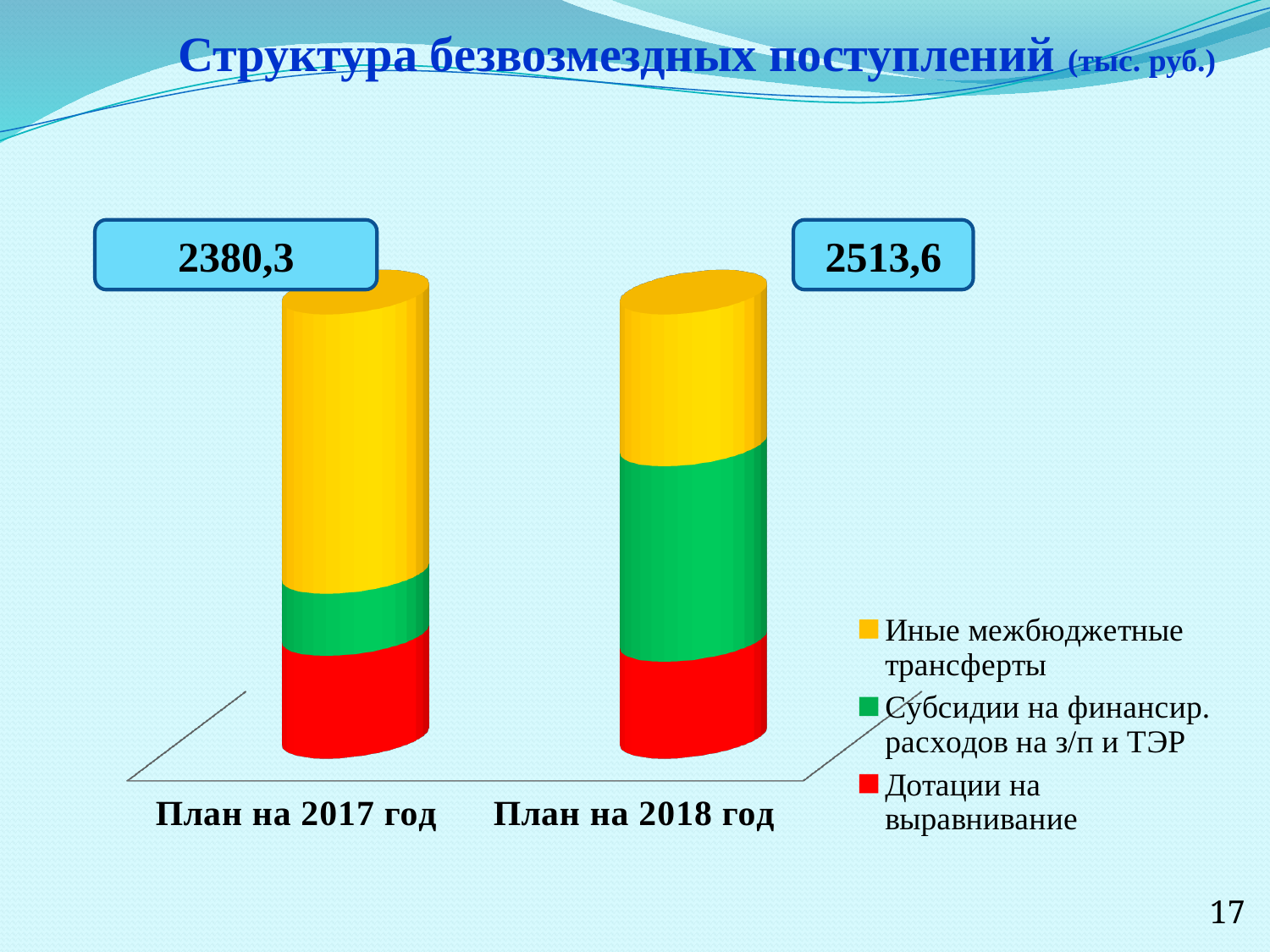
Which series makes up the smallest part of the "План на 2017 год" bar? Субсидии на финансир. расходов на з/п и ТЭР What is the total value shown for "План на 2018 год"? 2513,6 What kind of chart is shown on the slide? stacked bar chart Which colour represents "Дотации на выравнивание" in the legend? red Which series makes up the largest part of the "План на 2017 год" bar? Иные межбюджетные трансферты What is the total value shown for "План на 2017 год"? 2380,3 How many categories (bars) are shown on the chart? 2 Which bar has the larger total, "План на 2017 год" or "План на 2018 год"? План на 2018 год Is the "Субсидии на финансир. расходов на з/п и ТЭР" segment larger in "План на 2017 год" or in "План на 2018 год"? План на 2018 год What is the title of the chart? Структура безвозмездных поступлений (тыс. руб.) How many series does the legend list? 3 What is the difference between the totals for "План на 2018 год" and "План на 2017 год"? 133,3